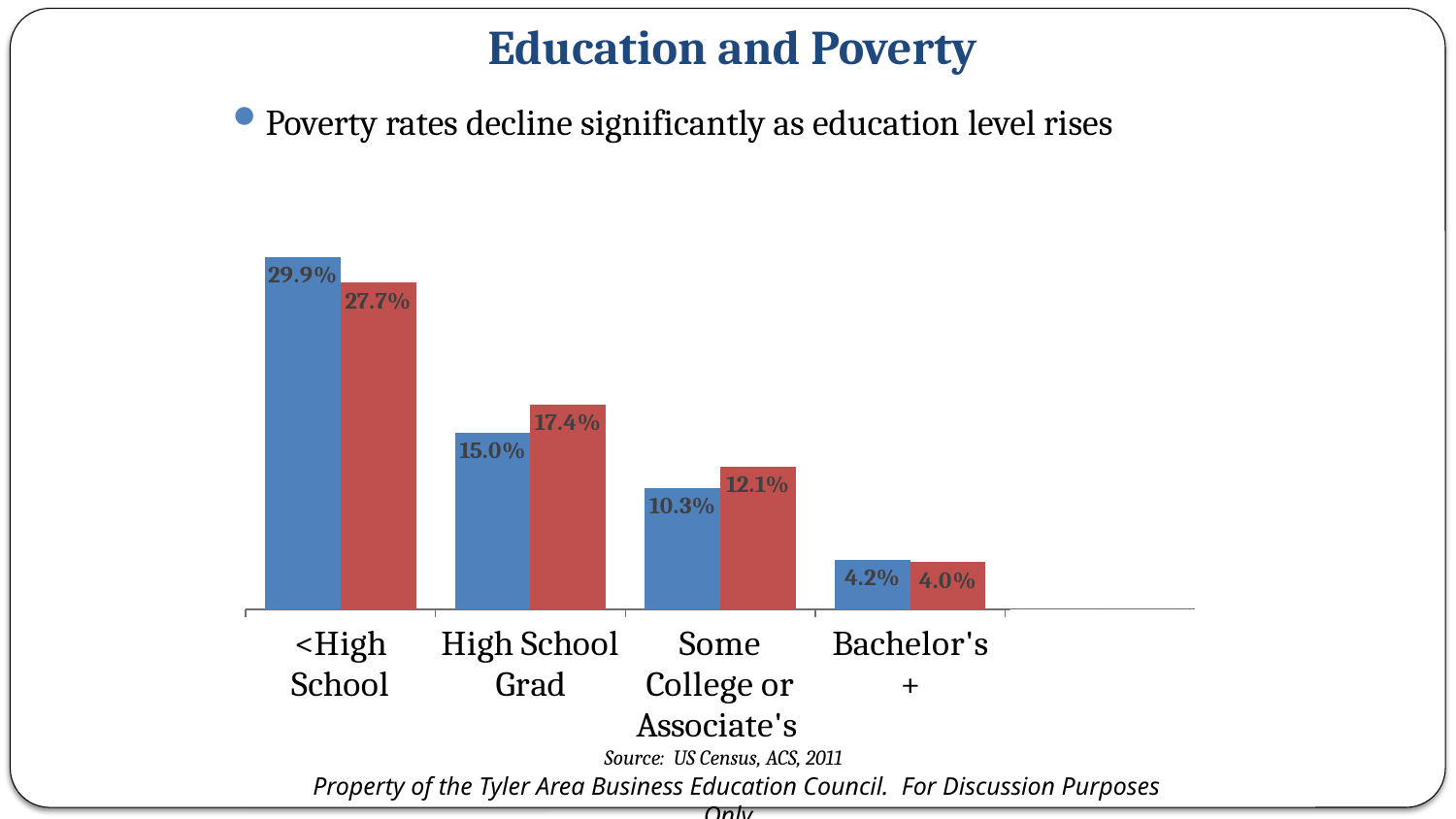
What is the value of the blue bar for <High School? 29.9% What is the value of the red bar for Bachelor's +? 4.0% What is the difference between the red bar for High School Grad and the red bar for Some College or Associate's? 5.3% Which category has the highest blue bar? <High School What is the value of the red bar for High School Grad? 17.4% Do the blue bar values rise or fall from <High School to Bachelor's +? fall How many education categories are shown on the x axis? 4 What is the value of the blue bar for Some College or Associate's? 10.3% What kind of chart is shown on the slide? bar chart Which category has the lowest red bar? Bachelor's + For High School Grad, which bar is larger, the blue or the red? red What is the difference between the blue and red bars for <High School? 2.2%